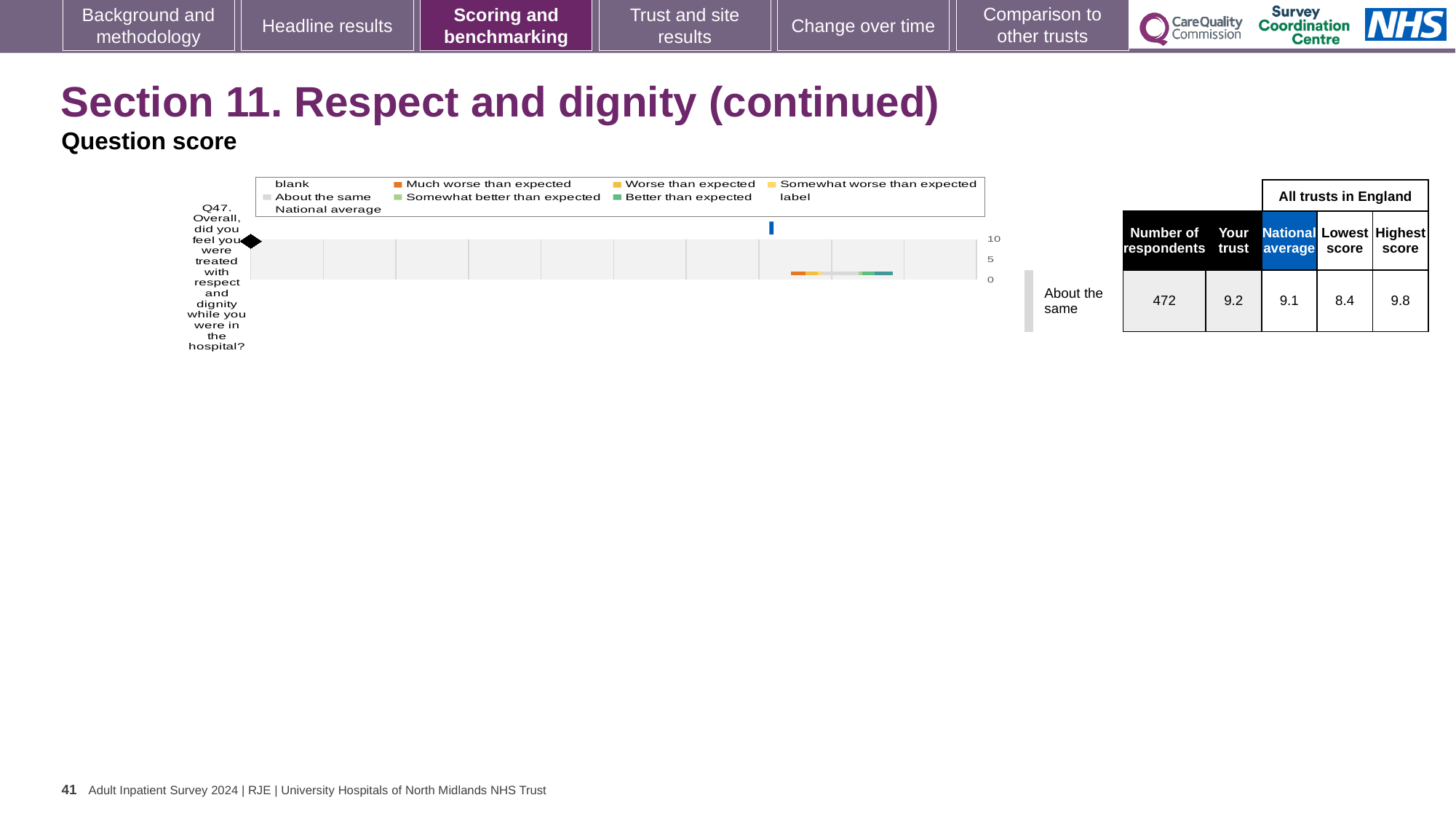
What is the highest score among all trusts in England for Q47? 9.8 What is the maximum value shown on the chart's score axis? 10 What kind of chart is used to show the Q47 score? bar chart How many respondents are shown for Q47? 472 What is the national average score shown for Q47? 9.1 Which legend entry is shown in orange on the chart? Much worse than expected Which is larger for Q47, the 'Your trust' score or the national average? Your trust What is the lowest score among all trusts in England for Q47? 8.4 What is the difference between the 'Your trust' score and the national average for Q47? 0.1 Which benchmarking category is the trust placed in for Q47? About the same What is the 'Your trust' score shown for Q47 on this slide? 9.2 What is the difference between the highest score and the lowest score for Q47? 1.4